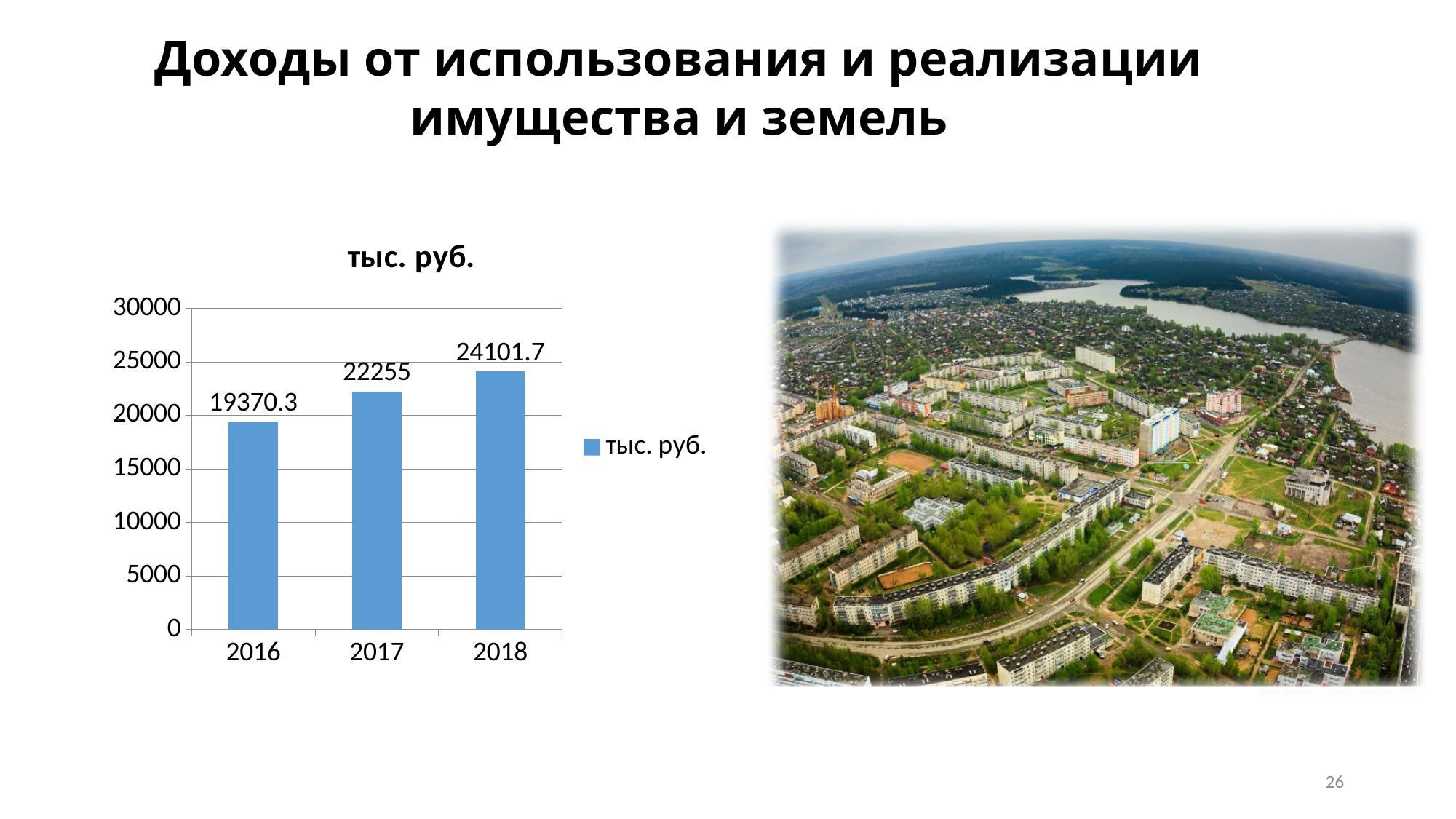
What is the difference between the values for 2018 and 2017? 1846.7 How many years are shown on the chart? 3 What is the value for 2018? 24101.7 Is the value for 2016 greater or less than 20000? less Which is larger, the value for 2016 or the value for 2018? 2018 Which year has the lowest value? 2016 What is the value for 2017? 22255 What is the difference between the values for 2017 and 2016? 2884.7 What kind of chart is shown on the slide? bar chart What is the value for 2016? 19370.3 Do the values rise or fall from 2016 to 2018? rise Which year has the highest value? 2018